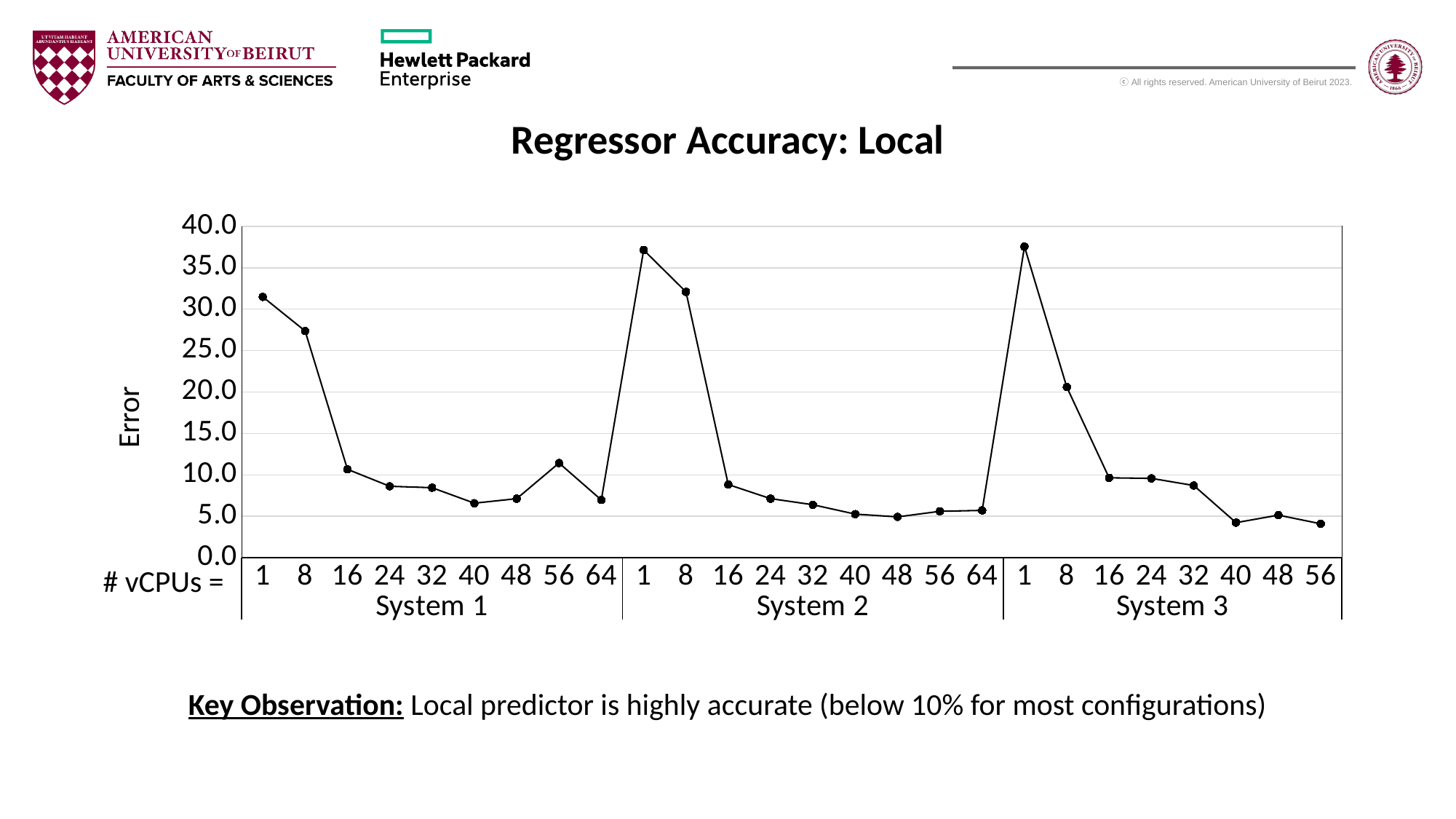
How many systems are shown along the x axis of the chart? 3 Does the error for System 2 rise or fall as the number of vCPUs increases from 1 to 16? fall What kind of chart is shown on the slide? line chart How many vCPU configurations are plotted for System 1? 9 Is the error for System 2 at 1 vCPU greater or less than 35? greater What is the label on the y axis of the chart? Error How many vCPU configurations are plotted for System 3? 8 Is the error for System 1 at 1 vCPU greater or less than 30? greater Is the error for System 1 at 56 vCPUs greater or less than 10? greater Which has the higher error at 8 vCPUs, System 1 or System 3? System 1 Which has the higher error at 1 vCPU, System 1 or System 2? System 2